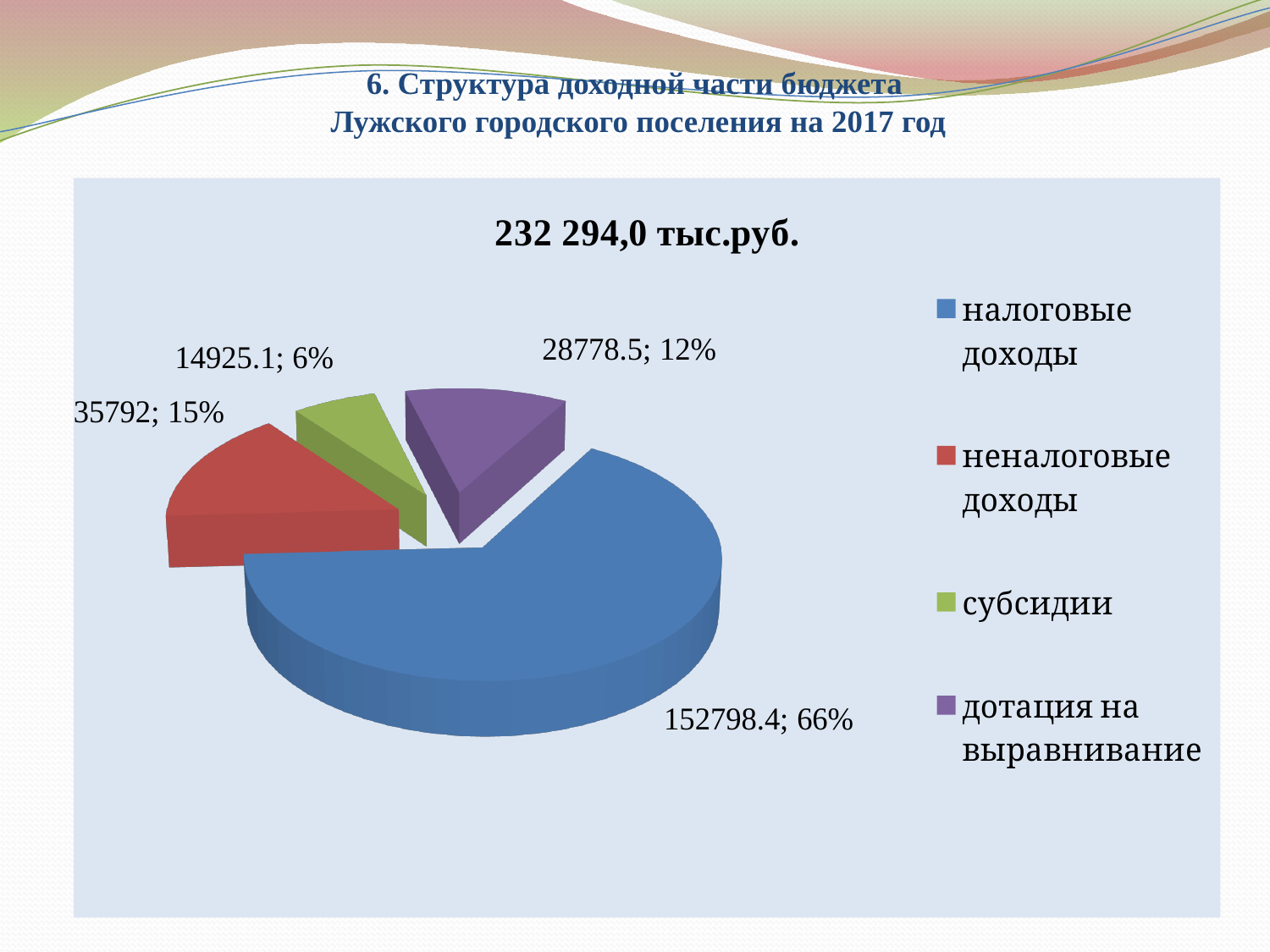
What share of the pie does налоговые доходы represent? 66% What kind of chart is shown on the slide? pie chart What is the value shown for неналоговые доходы? 35792 Which category has the smallest slice of the pie? субсидии How many categories does the legend list? 4 What is the value shown for дотация на выравнивание? 28778.5 What is the title shown above the pie chart? 232 294,0 тыс.руб. What is the value shown for субсидии? 14925.1 Which is larger, неналоговые доходы or дотация на выравнивание? неналоговые доходы Which category has the largest slice of the pie? налоговые доходы What share of the pie does дотация на выравнивание represent? 12% What is the value shown for налоговые доходы? 152798.4